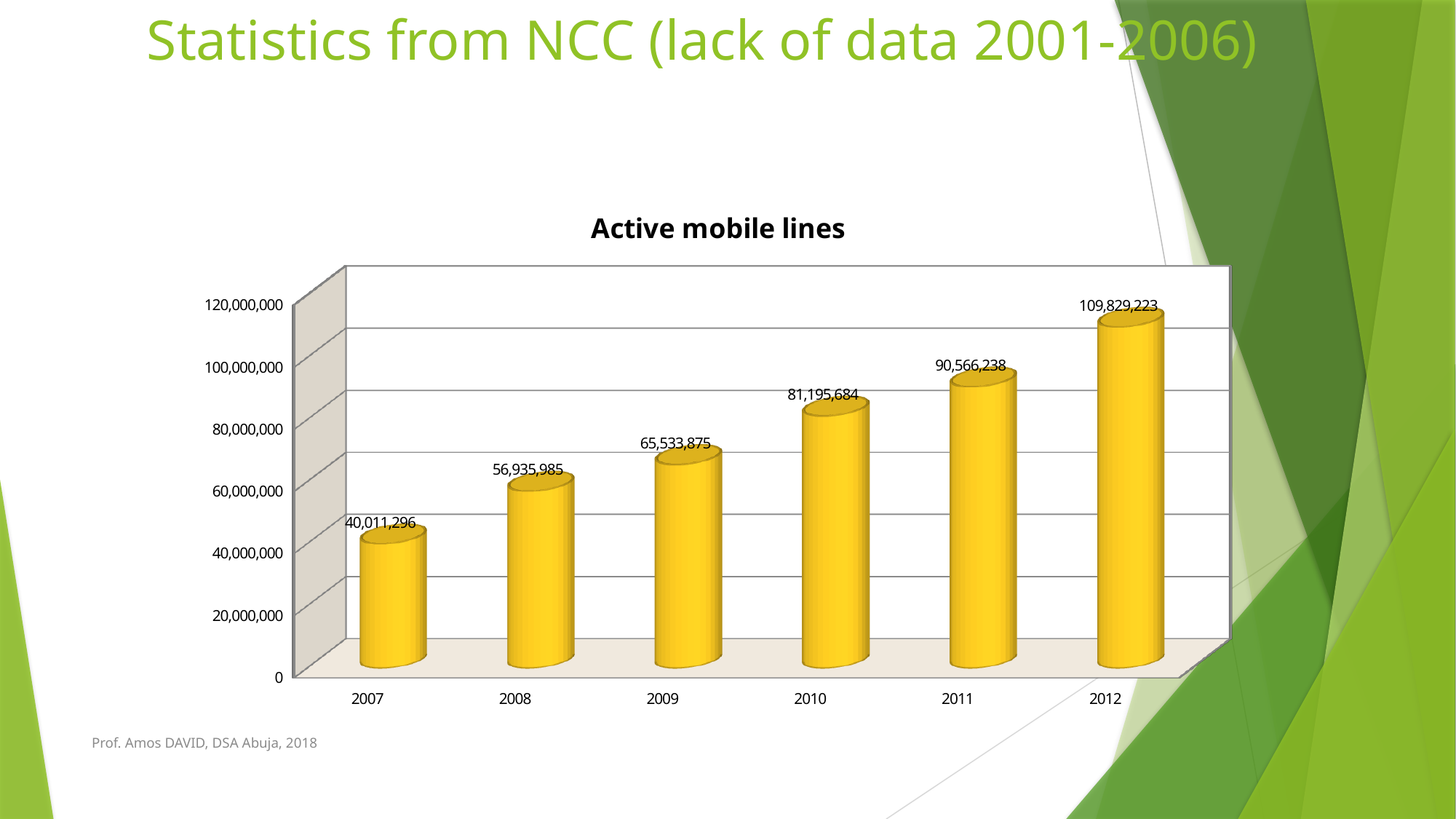
How many years are shown on the x axis of the chart? 6 What is the value for 2010 in the Active mobile lines chart? 81,195,684 Which is larger, the value for 2009 or the value for 2011? 2011 What is the value for 2007 in the Active mobile lines chart? 40,011,296 Do the values rise or fall from 2007 to 2012? rise What is the value for 2012 in the Active mobile lines chart? 109,829,223 Is the value for 2008 greater or less than 60,000,000? less What kind of chart is shown on the slide? bar chart What is the difference between the values for 2010 and 2009? 15,661,809 What is the difference between the values for 2012 and 2007? 69,817,927 Which year has the lowest number of active mobile lines? 2007 Which year has the highest number of active mobile lines? 2012